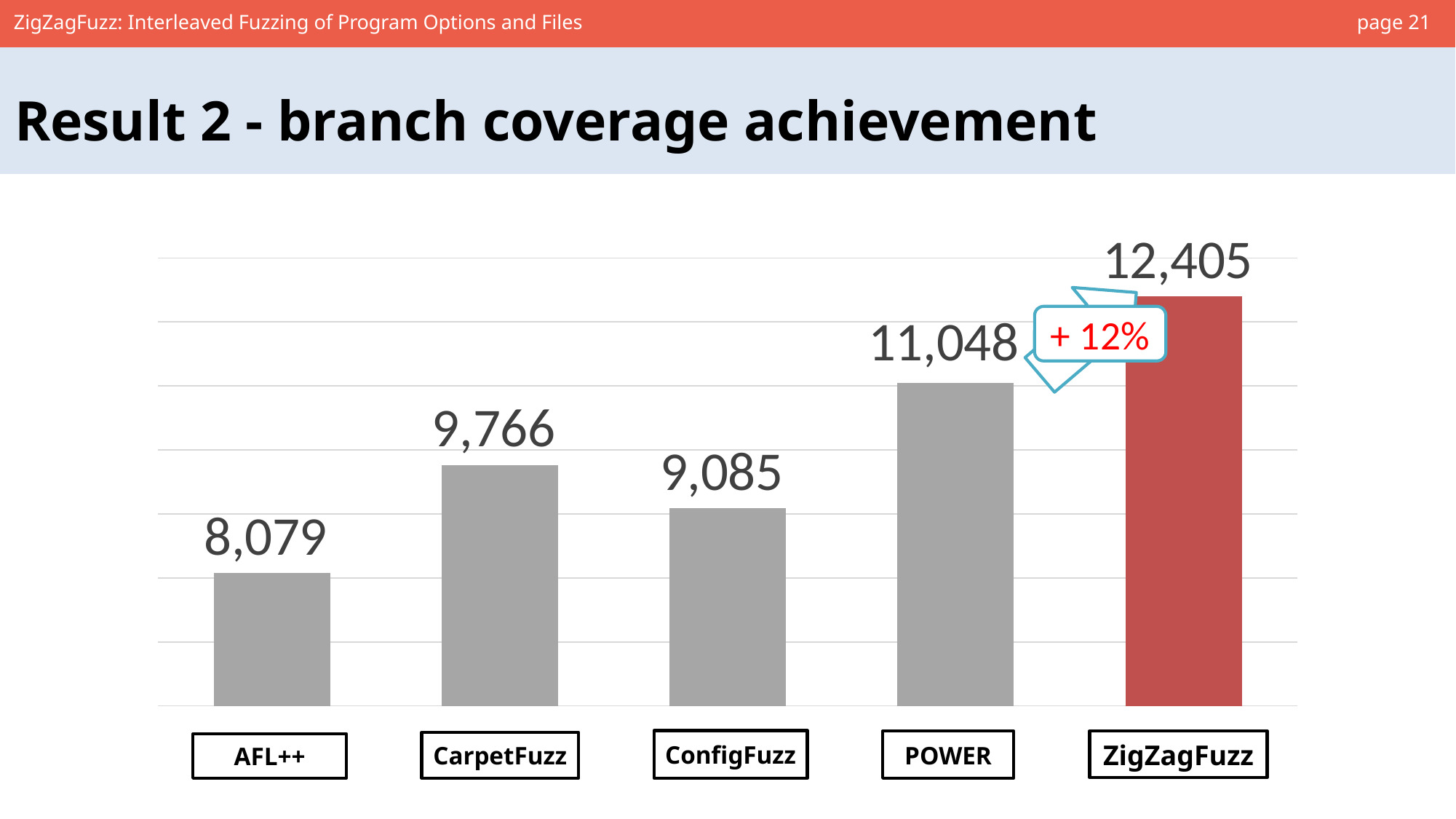
What is the branch coverage value for ZigZagFuzz? 12,405 Which fuzzer has the highest branch coverage? ZigZagFuzz What is the branch coverage value for POWER? 11,048 How many fuzzers are shown in the chart? 5 What is the branch coverage value for ConfigFuzz? 9,085 What is the difference between the ZigZagFuzz and POWER values? 1,357 Which has a larger value, CarpetFuzz or ConfigFuzz? CarpetFuzz Which fuzzer has the lowest branch coverage? AFL++ What kind of chart is shown on the slide? Bar chart What percentage improvement is shown in the callout next to the ZigZagFuzz bar? + 12% What is the branch coverage value for AFL++? 8,079 What is the difference between the CarpetFuzz and ConfigFuzz values? 681